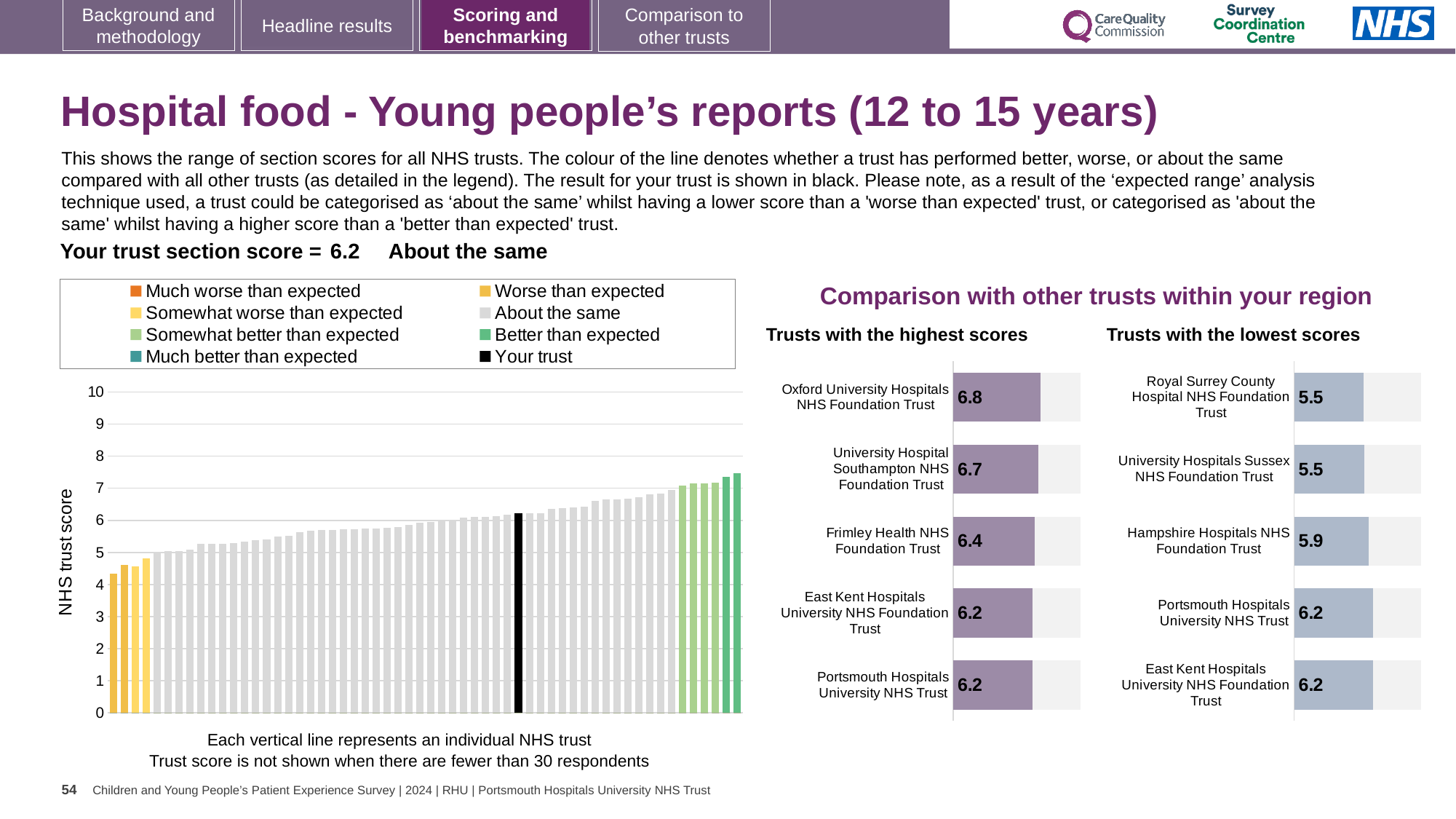
In the 'NHS trust score' chart on the left, do the bar values rise or fall from left to right? Rise In the 'Trusts with the lowest scores' chart, what is the score for Royal Surrey County Hospital NHS Foundation Trust? 5.5 In the 'Trusts with the highest scores' chart, what is the score for Oxford University Hospitals NHS Foundation Trust? 6.8 In the 'Trusts with the lowest scores' chart, how many trusts are listed? 5 In the 'Trusts with the highest scores' chart, what is the score for Frimley Health NHS Foundation Trust? 6.4 In the 'Trusts with the lowest scores' chart, what is the difference between the scores of Hampshire Hospitals NHS Foundation Trust and Royal Surrey County Hospital NHS Foundation Trust? 0.4 What kind of chart is the 'NHS trust score' chart on the left of the slide? Bar chart In the 'Trusts with the highest scores' chart, which trust has the highest score? Oxford University Hospitals NHS Foundation Trust In the 'Trusts with the lowest scores' chart, what is the score for Hampshire Hospitals NHS Foundation Trust? 5.9 In the 'Trusts with the highest scores' chart, what is the difference between the scores of Oxford University Hospitals NHS Foundation Trust and Frimley Health NHS Foundation Trust? 0.4 In the 'NHS trust score' chart on the left, is the value of the leftmost bar greater or less than 5? less In the 'Trusts with the lowest scores' chart, which is larger: the score for Hampshire Hospitals NHS Foundation Trust or University Hospitals Sussex NHS Foundation Trust? Hampshire Hospitals NHS Foundation Trust